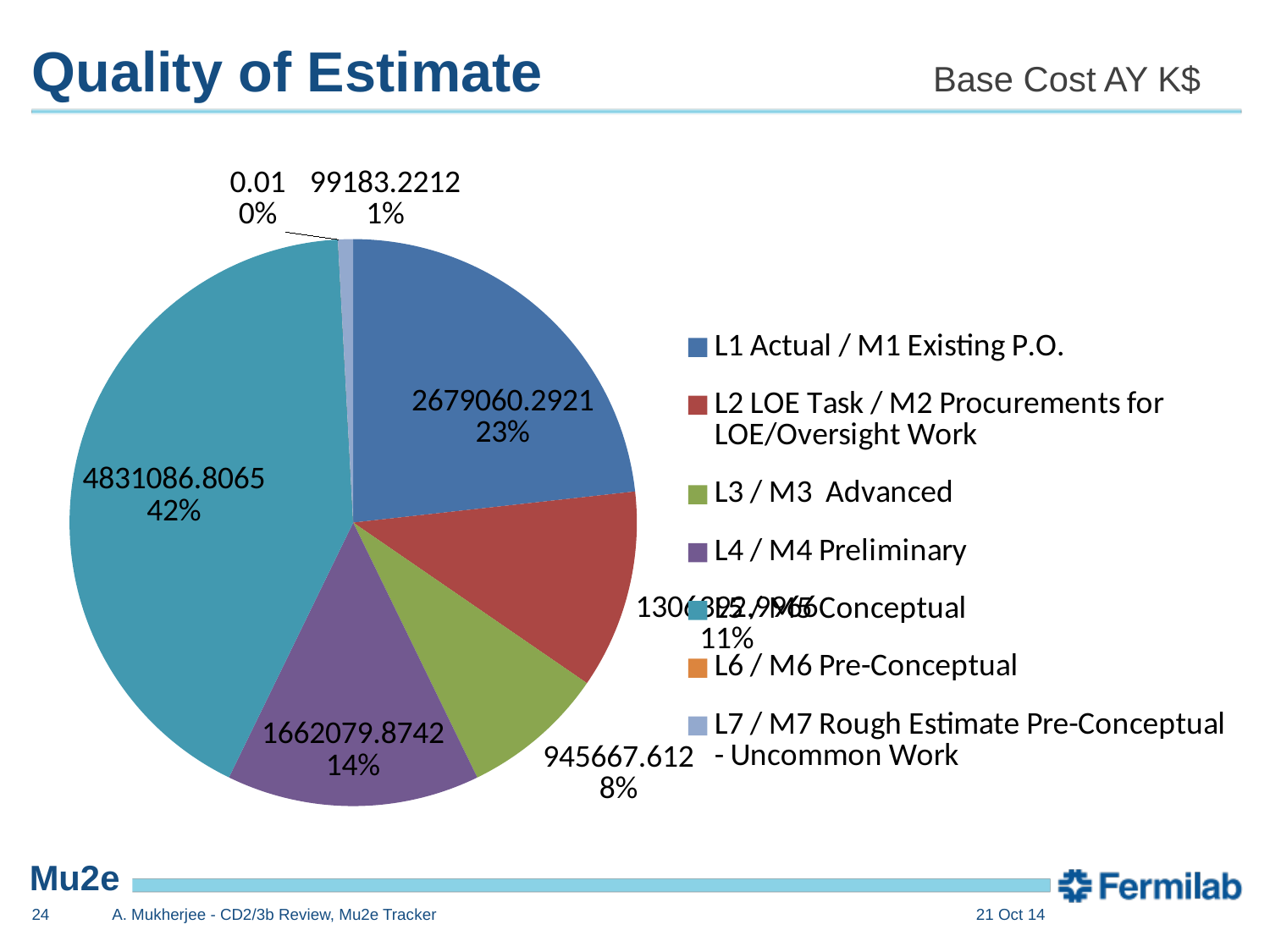
What share of the pie does L3 / M3 Advanced represent? 8% What is the value shown for L4 / M4 Preliminary? 1662079.8742 What share of the pie does L1 Actual / M1 Existing P.O. represent? 23% How many entries does the legend of the pie chart list? 7 What kind of chart is shown on the slide? pie chart What share of the pie does L5 / M5 Conceptual represent? 42% Which category has the largest slice of the pie? L5 / M5 Conceptual Which is larger, the value for L1 Actual / M1 Existing P.O. or the value for L4 / M4 Preliminary? L1 Actual / M1 Existing P.O. What is the value shown for L5 / M5 Conceptual? 4831086.8065 What is the value shown for L1 Actual / M1 Existing P.O.? 2679060.2921 Which category has the smallest slice of the pie? L6 / M6 Pre-Conceptual What is the difference between the values for L1 Actual / M1 Existing P.O. and L4 / M4 Preliminary? 1016980.4179